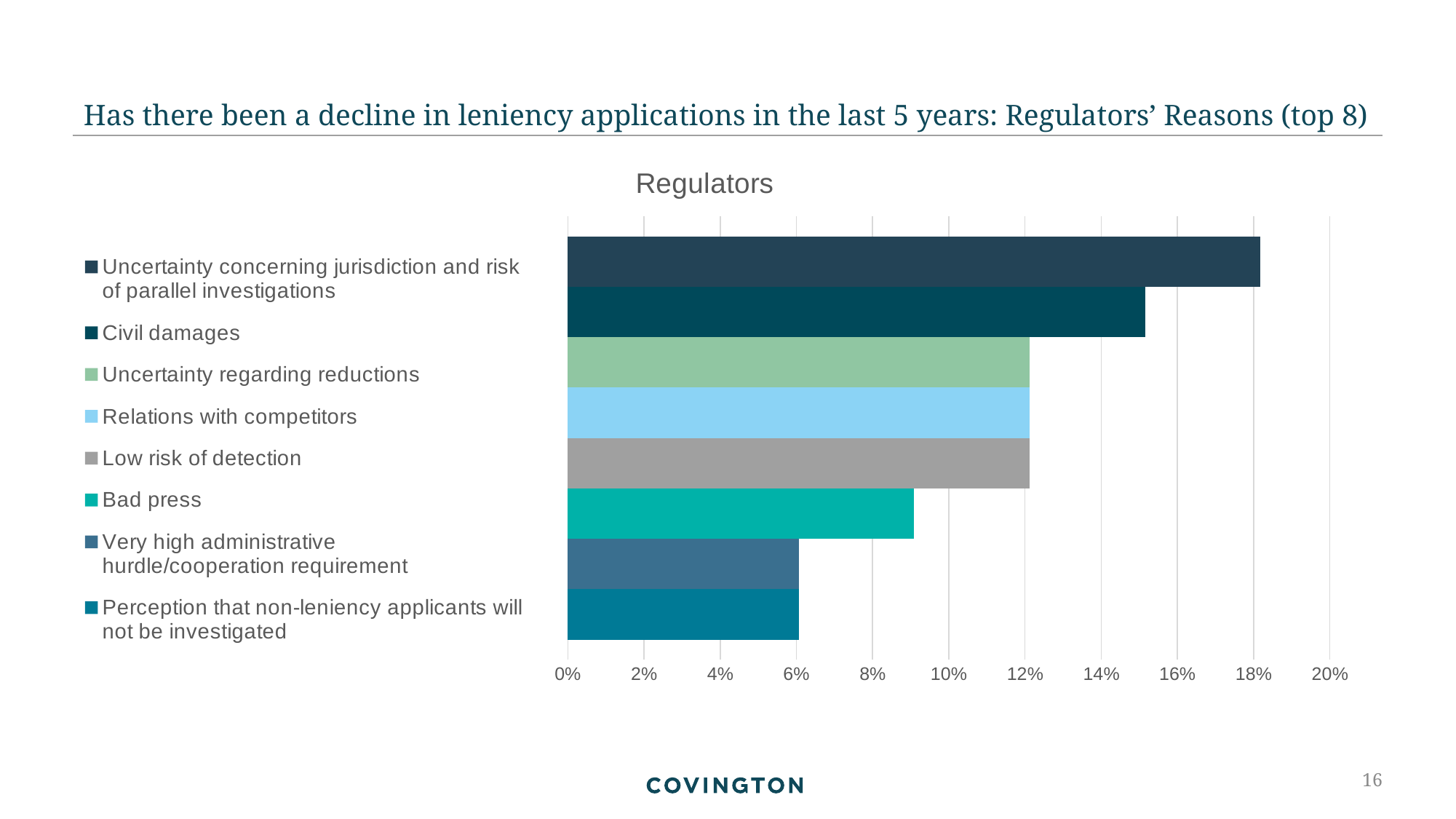
Which reason has the highest value in the chart? Uncertainty concerning jurisdiction and risk of parallel investigations Which is larger, the value for Low risk of detection or the value for Perception that non-leniency applicants will not be investigated? Low risk of detection Is the value for Bad press greater or less than 10%? less Is the value for Very high administrative hurdle/cooperation requirement greater or less than 8%? less Is the value for Low risk of detection greater or less than 10%? greater How many bars are plotted in the chart? 8 How many entries does the legend list? 8 What is the title of the chart? Regulators Which is larger, the value for Civil damages or the value for Bad press? Civil damages What kind of chart is shown on the slide? bar chart